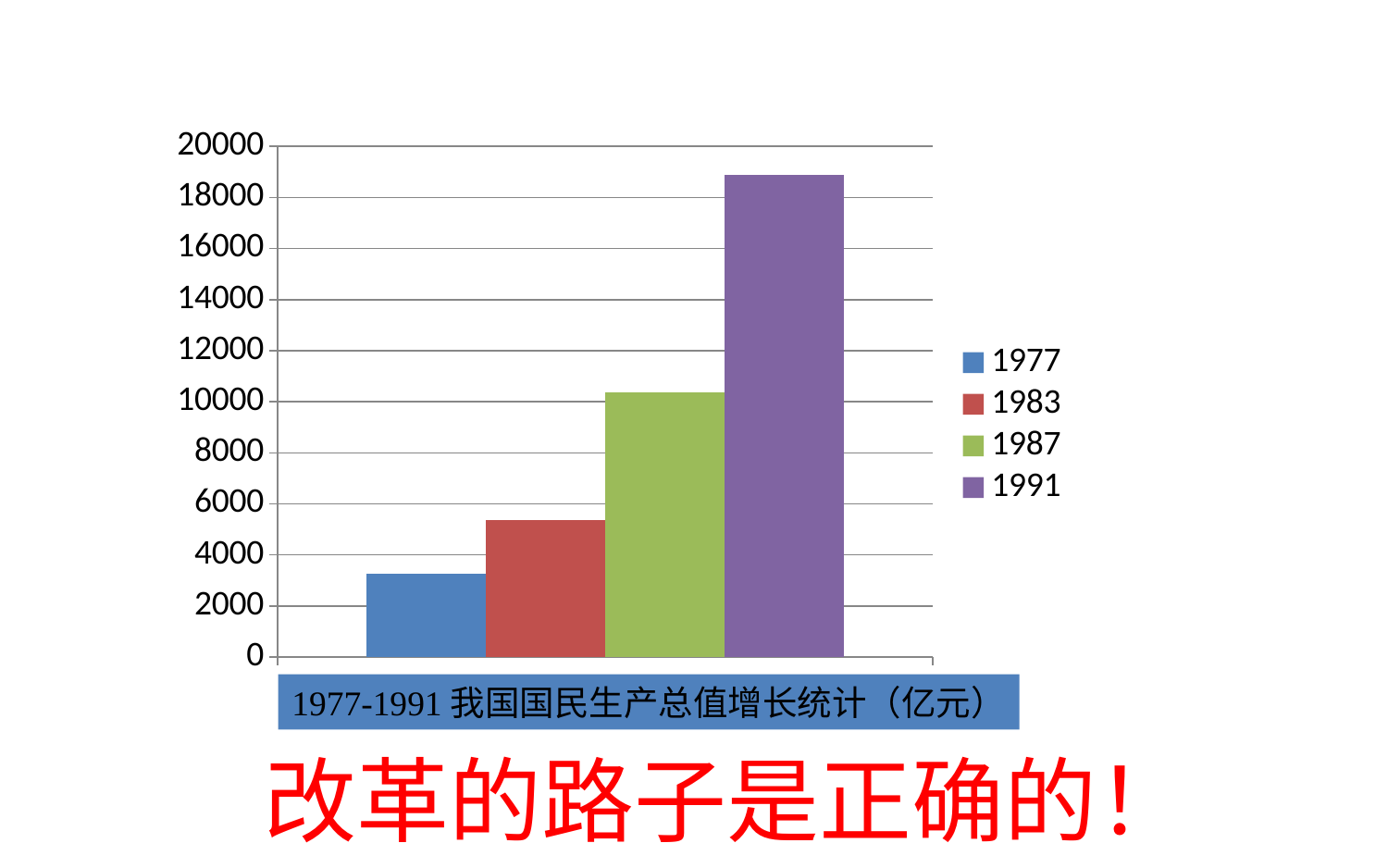
Which year has the lowest bar? 1977 How many bars are plotted in the chart? 4 Is the value for 1991 greater or less than 18000? greater Is the value for 1987 greater or less than 10000? greater Do the values rise or fall from 1977 to 1991? rise What colour is the bar for 1991? purple What kind of chart is shown on the slide? bar chart Is the value for 1983 greater or less than 6000? less Which is larger, the value for 1983 or the value for 1987? 1987 Which year has the highest bar? 1991 How many series does the legend list? 4